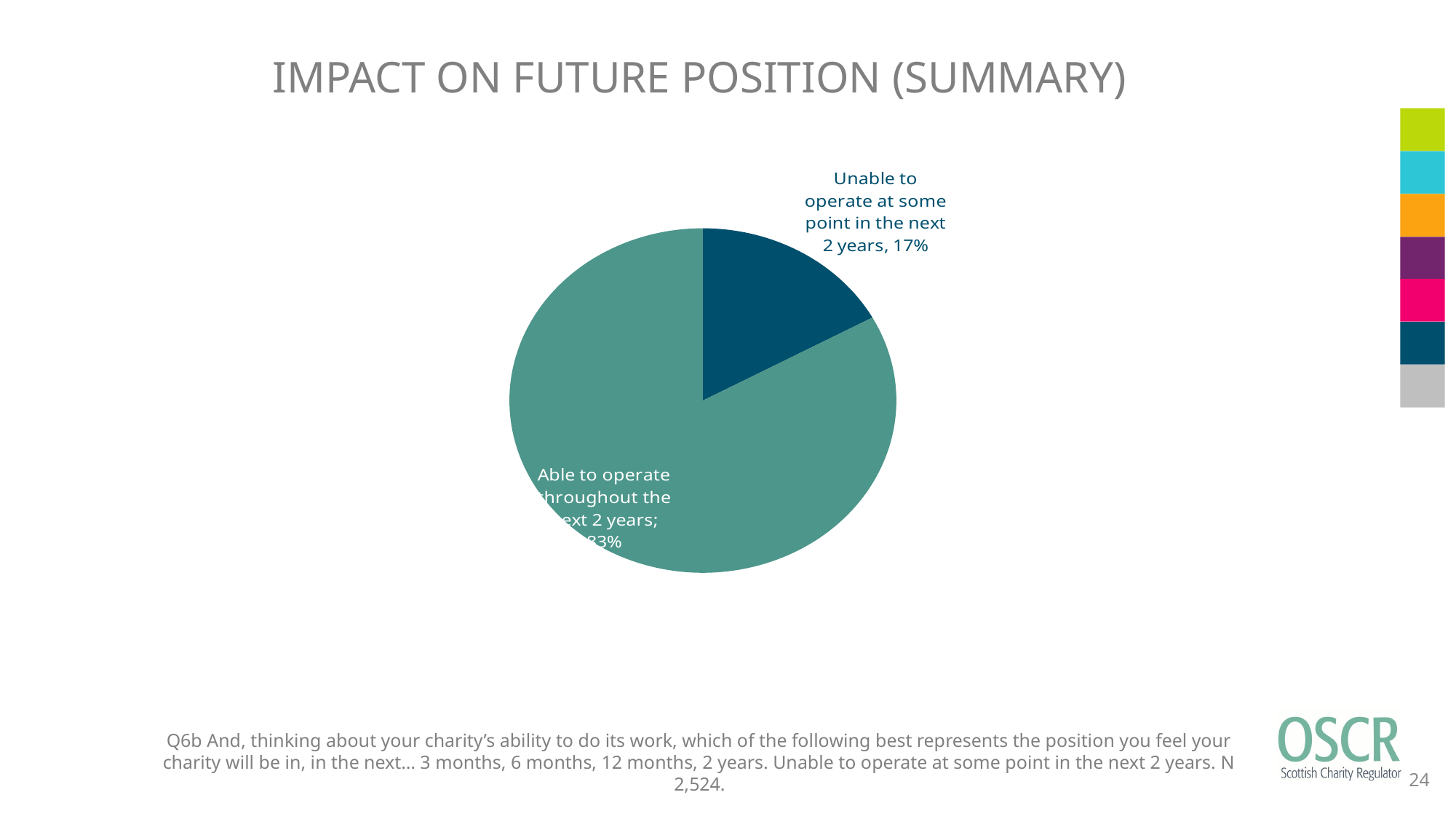
What share of the pie does the 'Unable to operate at some point in the next 2 years' slice represent? 17% Which slice of the pie chart is the largest? Able to operate throughout the next 2 years Which is larger: the share of charities able to operate throughout the next 2 years or the share unable to operate at some point in the next 2 years? Able to operate throughout the next 2 years What percentage of charities said they would be unable to operate at some point in the next 2 years? 17% What percentage of charities said they would be able to operate throughout the next 2 years? 83% What is the difference in percentage points between the 'Able to operate throughout the next 2 years' slice and the 'Unable to operate at some point in the next 2 years' slice? 66 percentage points What is the sample size (N) stated in the footnote below the chart? 2,524 What kind of chart is shown on the slide? Pie chart What is the title of the slide containing the pie chart? IMPACT ON FUTURE POSITION (SUMMARY) Which slice of the pie chart is the smallest? Unable to operate at some point in the next 2 years How many slices does the pie chart have? 2